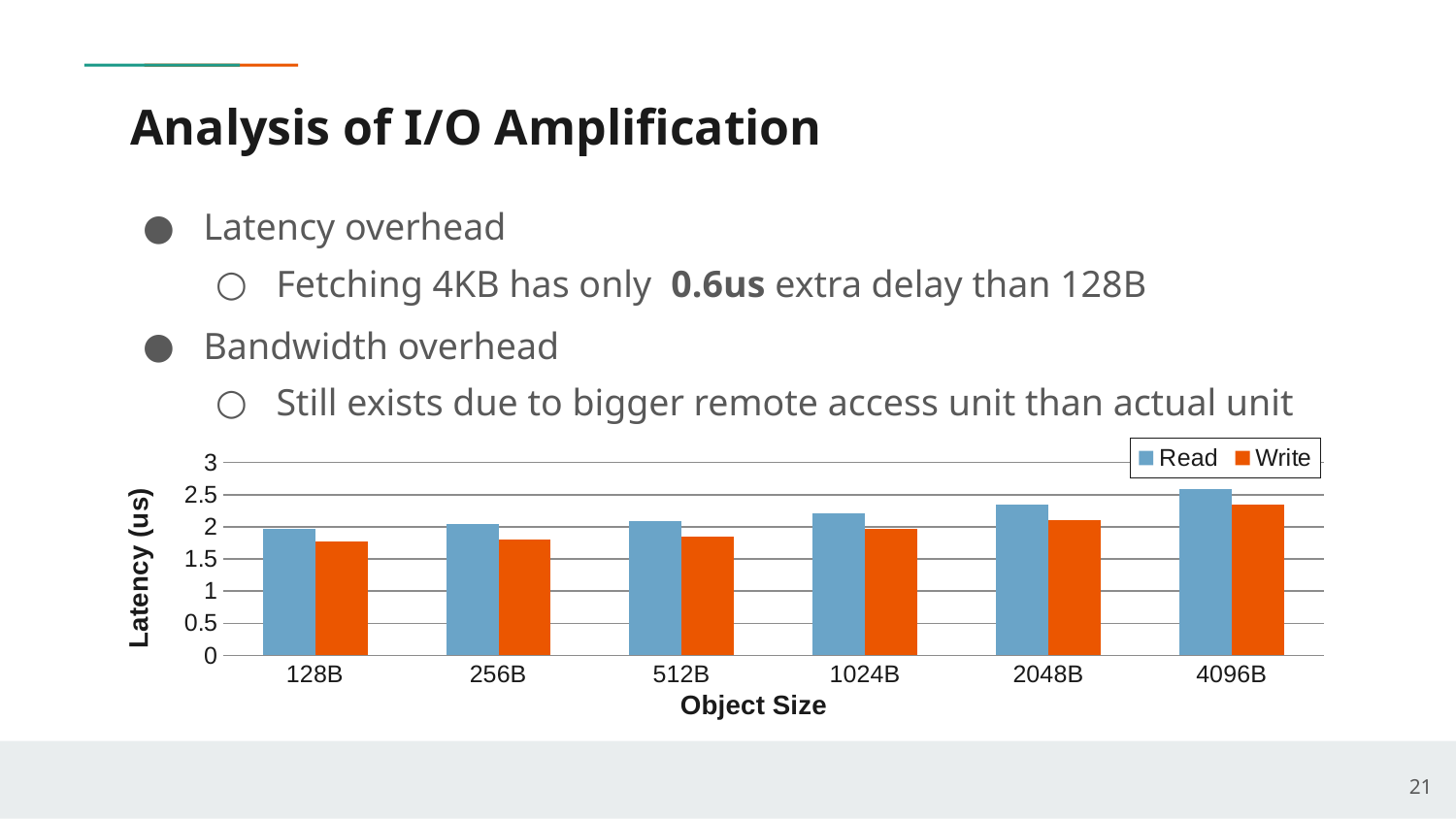
How many series does the chart's legend list? 2 What kind of chart is shown on the slide? bar chart How many object size categories are shown on the x axis of the chart? 6 At 128B, which is larger, the Read latency or the Write latency? Read Which object size has the highest Write latency? 4096B At 4096B, which is larger, the Read latency or the Write latency? Read What is the title of the chart's y axis? Latency (us) Is the Write latency for 128B greater or less than 2? less Which object size has the highest Read latency? 4096B Do the Read latency values rise or fall as object size increases along the x axis? rise Is the Read latency for 4096B greater or less than 2? greater Which object size has the lowest Read latency? 128B